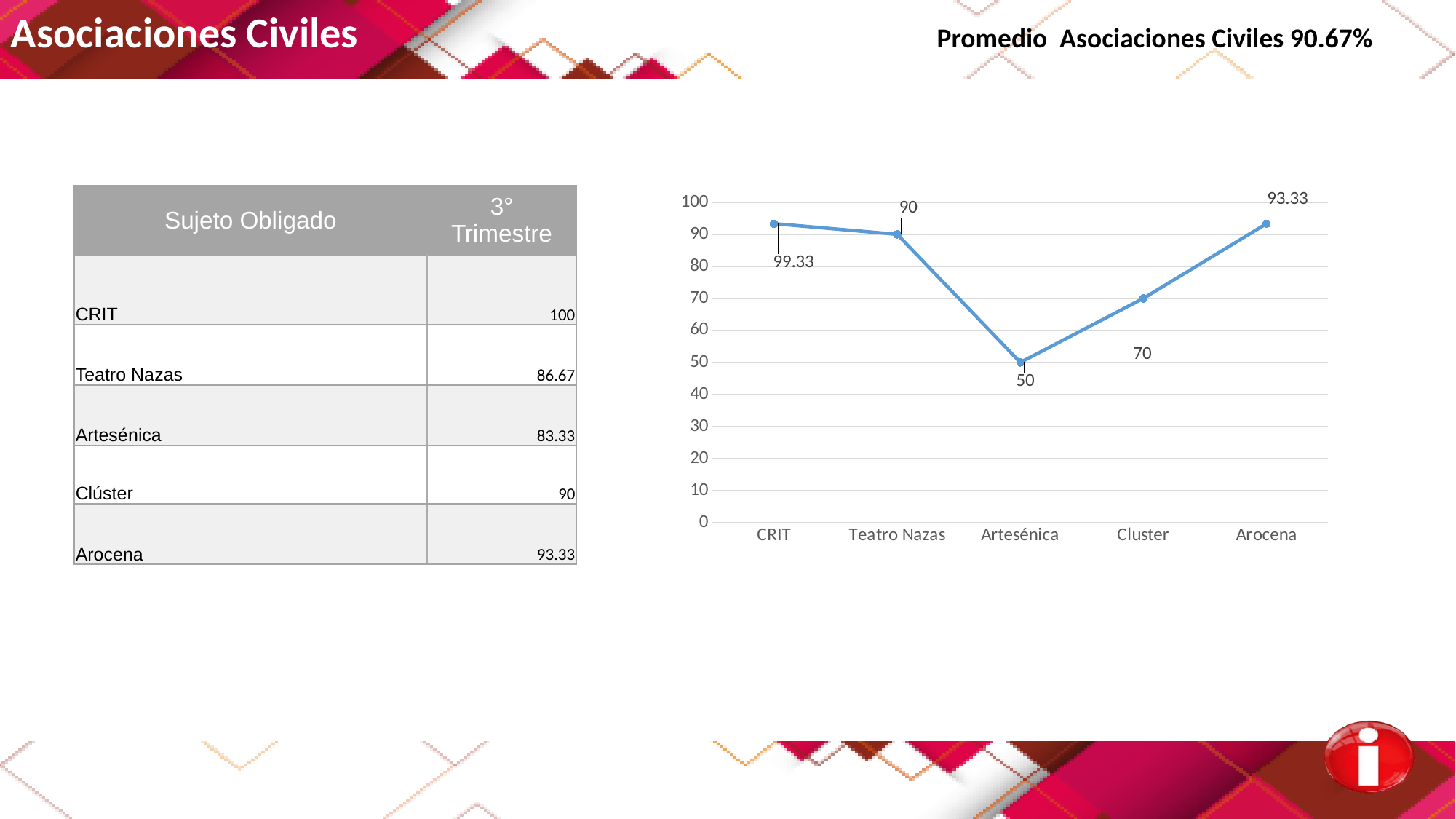
Is the value for Cluster in the chart greater or less than 80? less In the chart, what is the difference between the values for Teatro Nazas and Artesénica? 40 In the chart, what is the value for Arocena? 93.33 In the chart, what is the value for Artesénica? 50 What type of chart is shown on the slide? line chart How many categories are plotted on the x axis of the chart? 5 In the chart, which is larger, the value for Cluster or the value for Arocena? Arocena In the chart, does the line rise or fall from Artesénica to Arocena? rise In the chart, what is the value for Cluster? 70 Which category has the lowest value in the chart? Artesénica